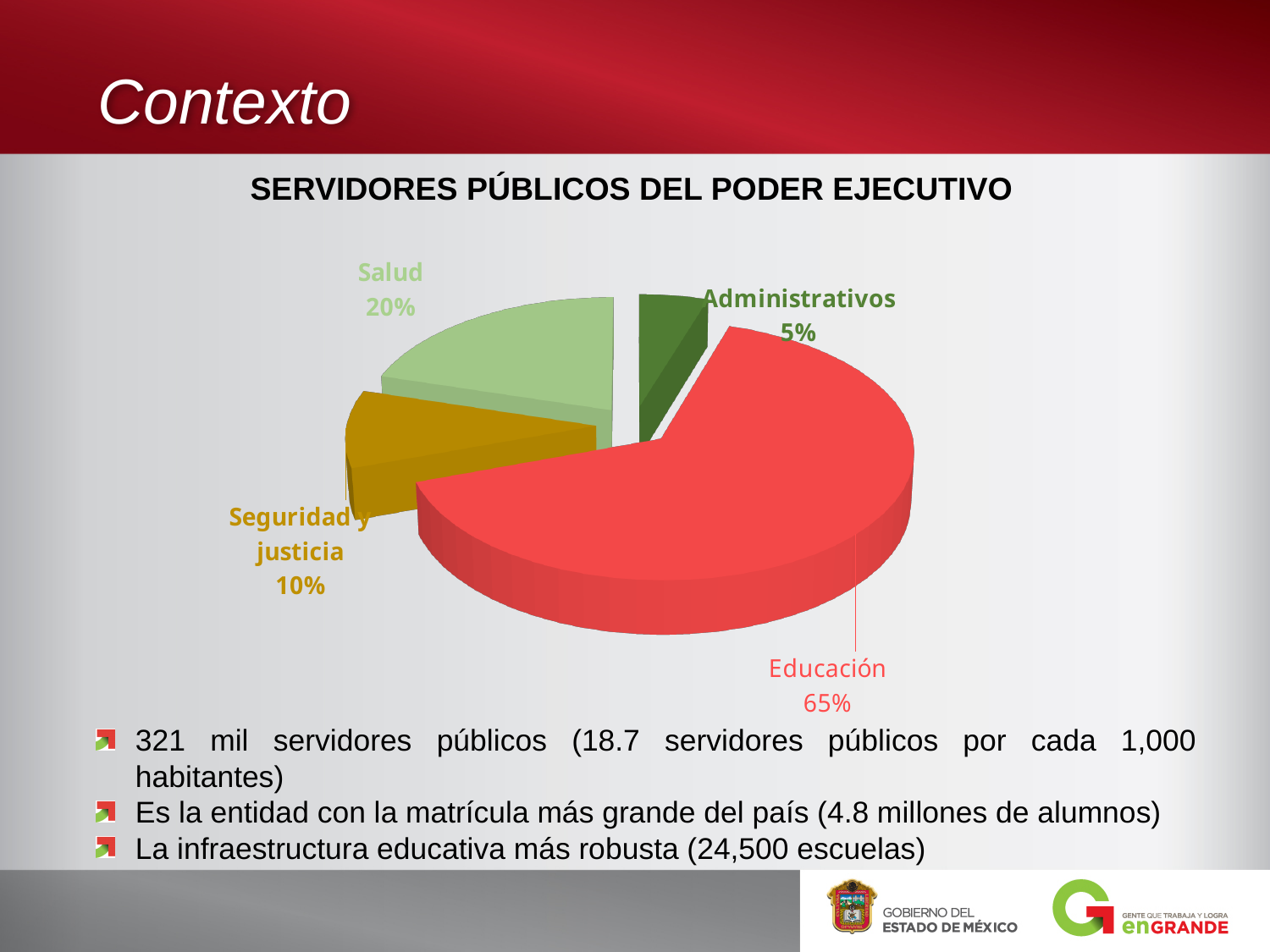
How many categories are shown in the pie chart? 4 What percentage of the pie does Educación represent? 65% Which category has the smallest share of the pie? Administrativos Which category has the largest share of the pie? Educación Which is larger, the share for Salud or the share for Seguridad y justicia? Salud What colour is the Educación slice? Red What percentage of the pie does Administrativos represent? 5% What percentage of the pie does Salud represent? 20% What type of chart is shown on the slide? Pie chart What percentage of the pie does Seguridad y justicia represent? 10% What is the difference in percentage points between Educación and Salud? 45 What is the title of the chart? SERVIDORES PÚBLICOS DEL PODER EJECUTIVO